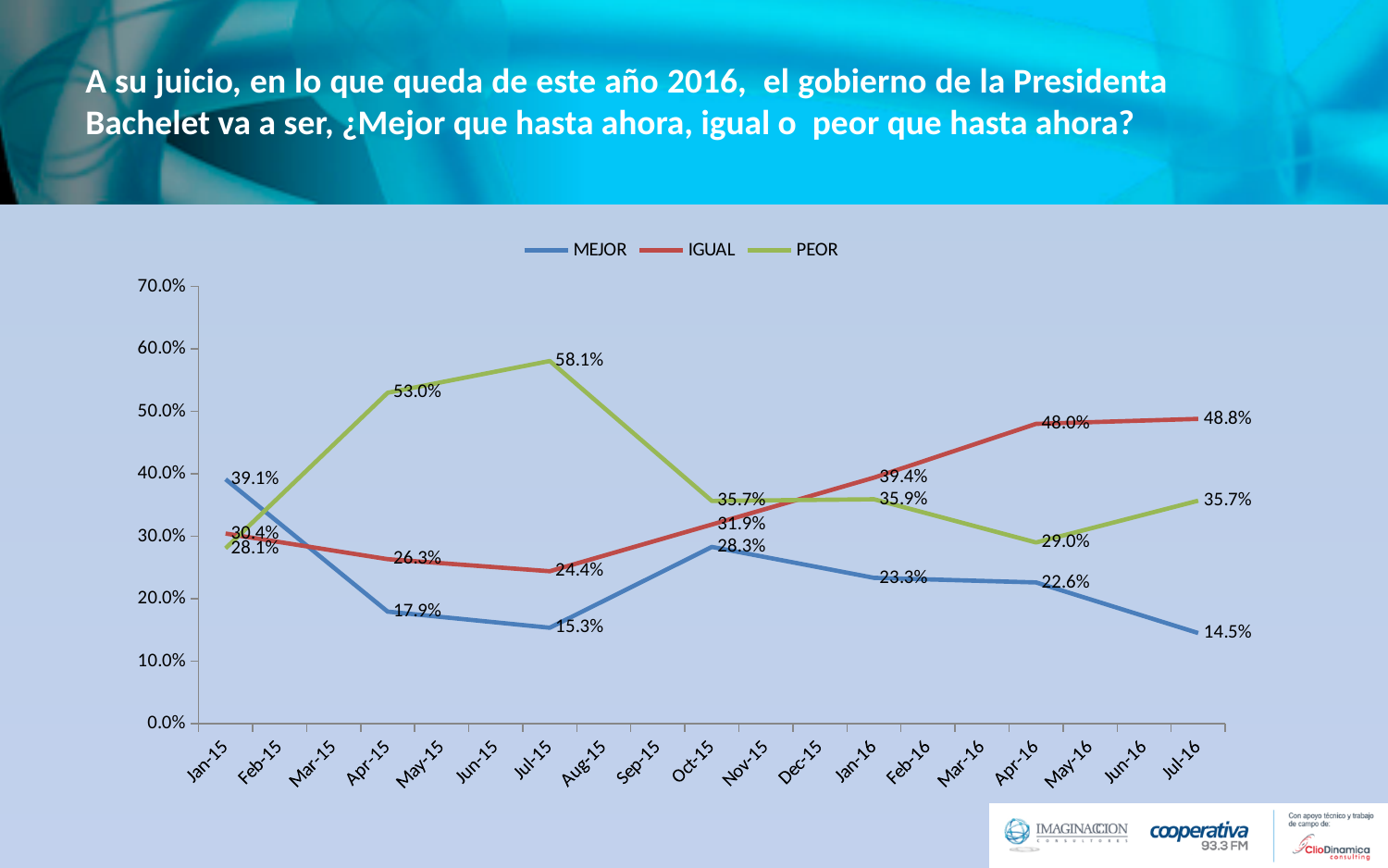
What is the value of MEJOR in Jan-15? 39.1% In Apr-16, which is larger, IGUAL or PEOR? IGUAL Is the value for PEOR in Apr-15 greater or less than 50.0%? greater Does the IGUAL series rise or fall from Jul-15 to Jul-16? rise What colour is the line for the PEOR series? green In which month does the MEJOR series reach its lowest value? Jul-16 How many series does the legend list? 3 What kind of chart is shown on the slide? line chart In which month does the PEOR series reach its highest value? Jul-15 What is the difference between IGUAL and MEJOR in Jul-16? 34.3 percentage points What is the value of IGUAL in Jul-16? 48.8% What is the value of PEOR in Jul-15? 58.1%